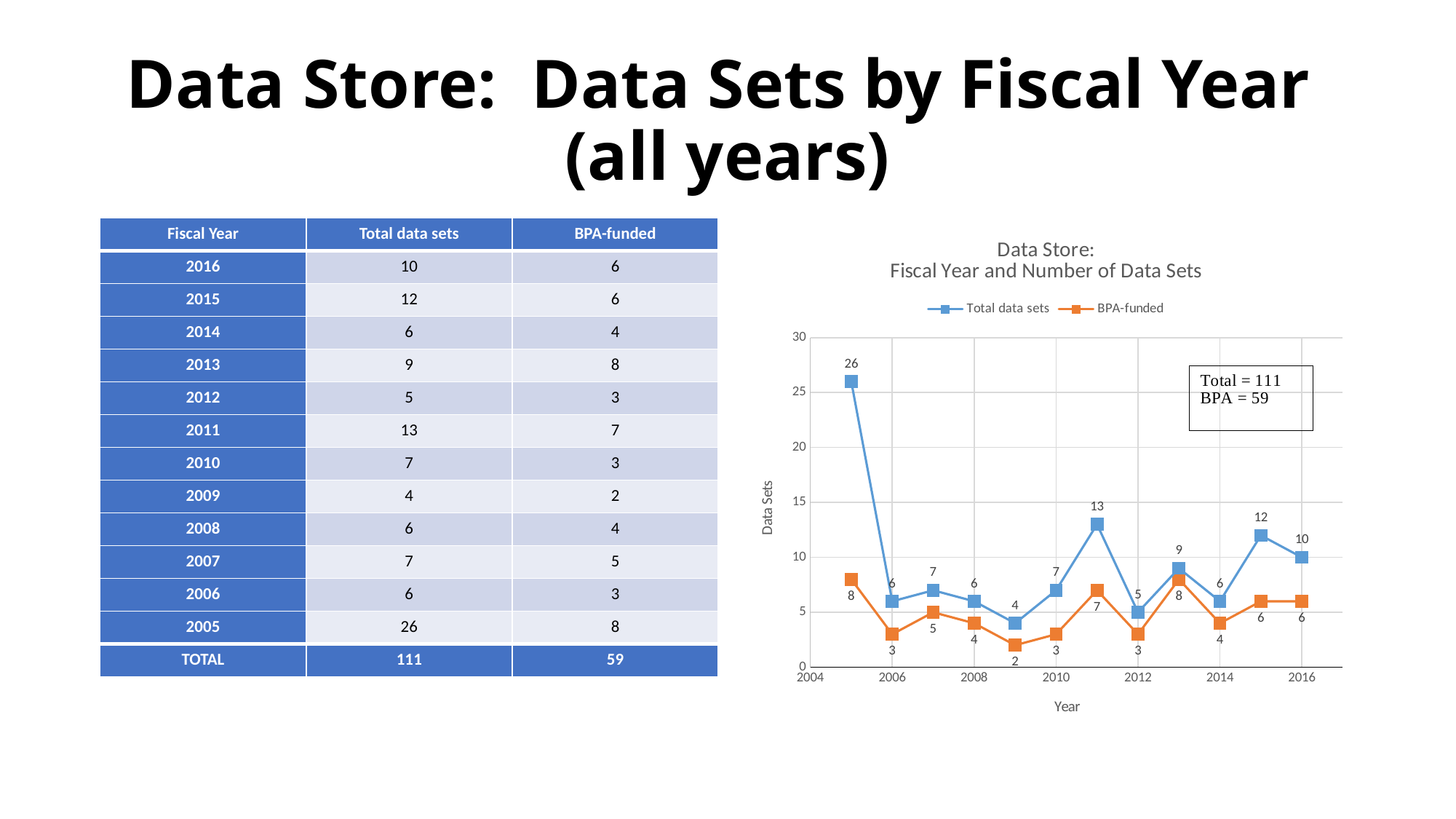
Which year has the highest value for Total data sets? 2005 Is the value of Total data sets for 2005 greater or less than 20? greater Which year has the lowest BPA-funded value? 2009 How many years are plotted on the chart? 12 What is the title of the chart? Data Store: Fiscal Year and Number of Data Sets What is the value of Total data sets for 2011? 13 What is the BPA-funded value for 2013? 8 How many series does the legend list? 2 What is the value of Total data sets for 2005? 26 What is the difference between Total data sets and BPA-funded in 2011? 6 What kind of chart is shown? line chart Which is larger, Total data sets in 2015 or Total data sets in 2016? 2015